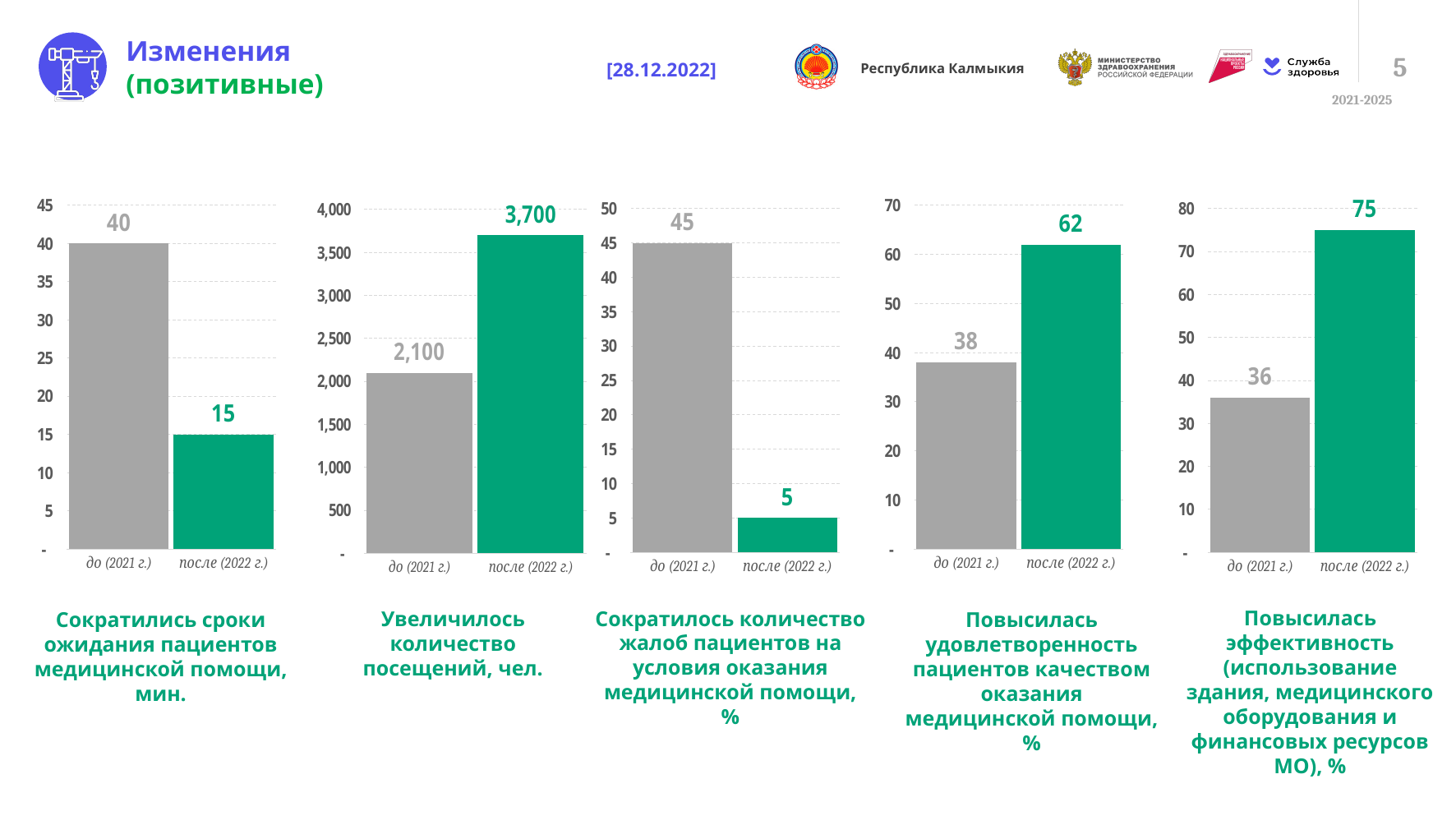
In the fourth chart from the left (patient satisfaction, %), what is the value for 'до (2021 г.)'? 38 How many bar charts are shown on the slide? 5 In the middle chart (patient complaints, %), which category has the highest value? до (2021 г.) What type of chart is the leftmost chart (waiting time for medical care, min.)? bar chart In the second chart from the left (number of visits, чел.), what is the difference between the 'после (2022 г.)' and 'до (2021 г.)' values? 1,600 In the leftmost chart (waiting time for medical care, min.), what is the value for 'до (2021 г.)'? 40 In the middle chart (patient complaints, %), what is the value for 'после (2022 г.)'? 5 In the leftmost chart (waiting time for medical care, min.), what is the value for 'после (2022 г.)'? 15 In the second chart from the left (number of visits, чел.), what is the value for 'после (2022 г.)'? 3,700 In the fourth chart from the left (patient satisfaction, %), what is the difference between the 'после (2022 г.)' and 'до (2021 г.)' values? 24 In the rightmost chart (efficiency, %), what is the value for 'после (2022 г.)'? 75 In the rightmost chart (efficiency, %), which is larger: the value for 'до (2021 г.)' or 'после (2022 г.)'? после (2022 г.)